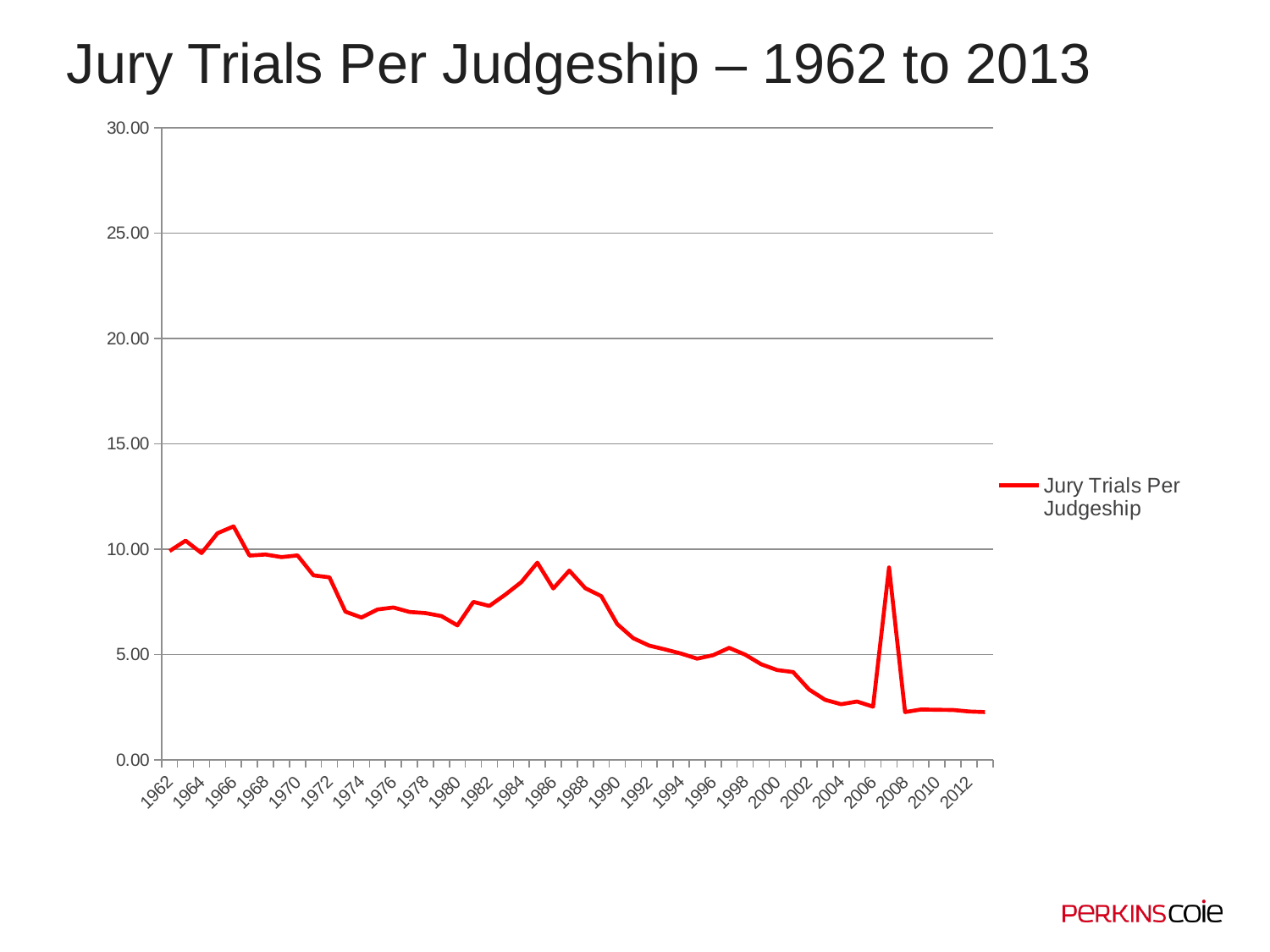
Is the value for Jury Trials Per Judgeship in 1974 greater or less than 10.00? less What is the name of the series shown in the legend? Jury Trials Per Judgeship What kind of chart is shown on the slide? line chart Overall, do the values for Jury Trials Per Judgeship rise or fall from 1962 to 2013? fall Which year has the larger value for Jury Trials Per Judgeship, 1985 or 1995? 1985 Is the value for Jury Trials Per Judgeship in 1966 greater or less than 10.00? greater What colour is the line plotted on the chart? red Which year has the larger value for Jury Trials Per Judgeship, 1966 or 2013? 1966 How many series does the legend list? 1 Is the value for Jury Trials Per Judgeship in 2013 greater or less than 5.00? less In which year is the value for Jury Trials Per Judgeship highest? 1966